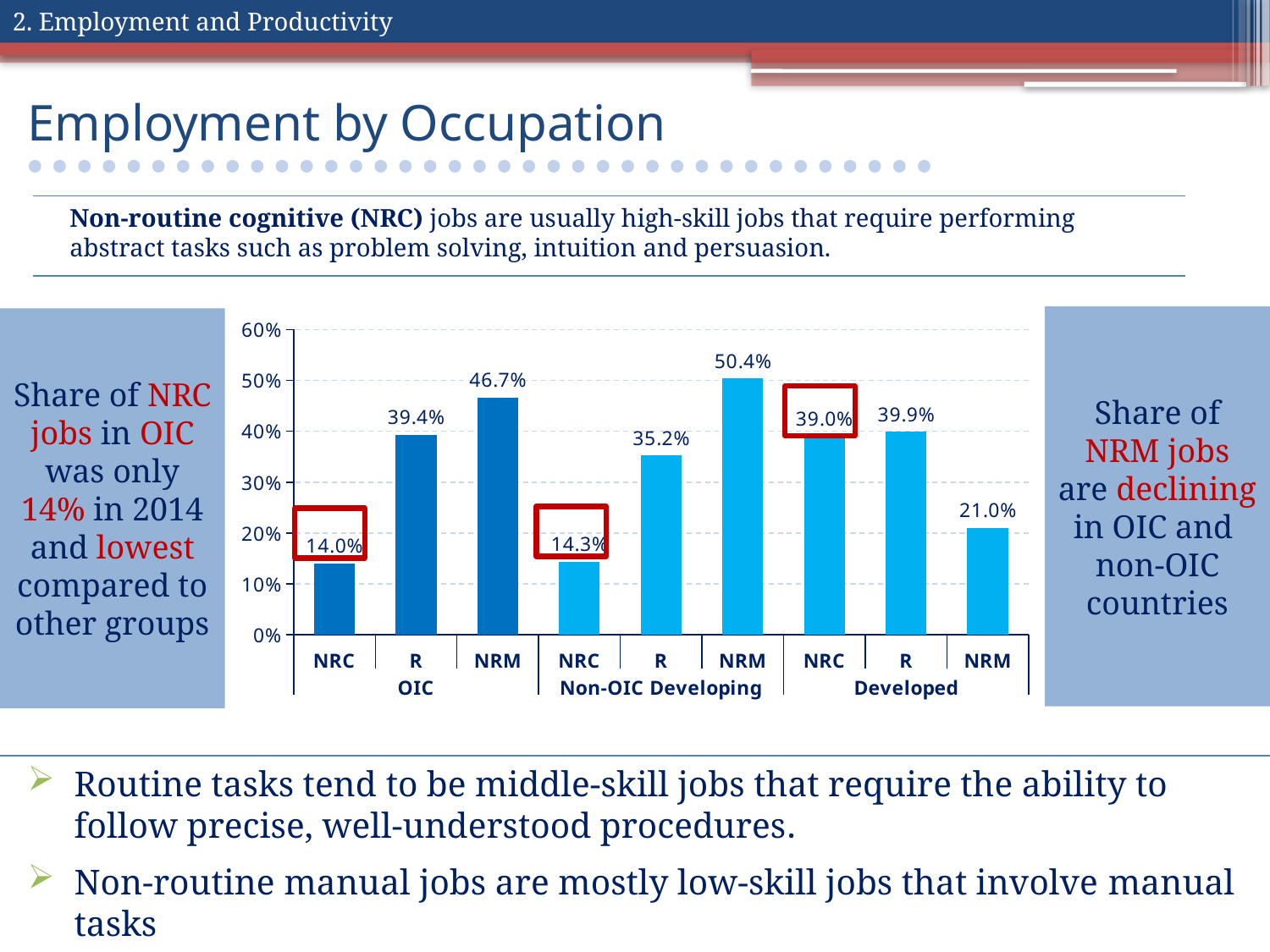
Which bar has the highest value in the chart? NRM in Non-OIC Developing Which bar has the lowest value in the chart? NRC in OIC How many bars are plotted in the chart? 9 What kind of chart is shown on the slide? bar chart What is the value for NRC in the OIC group? 14.0% What is the value for R in the Developed group? 39.9% What is the difference between the NRM value in OIC and the NRM value in Developed? 25.7% What is the value for NRM in the Non-OIC Developing group? 50.4% Is the value for NRC in the Developed group greater or less than 30%? greater Which is larger: the R value in OIC or the R value in Non-OIC Developing? R in OIC What is the value for NRM in the Developed group? 21.0% How many country groups are shown along the x axis of the chart? 3